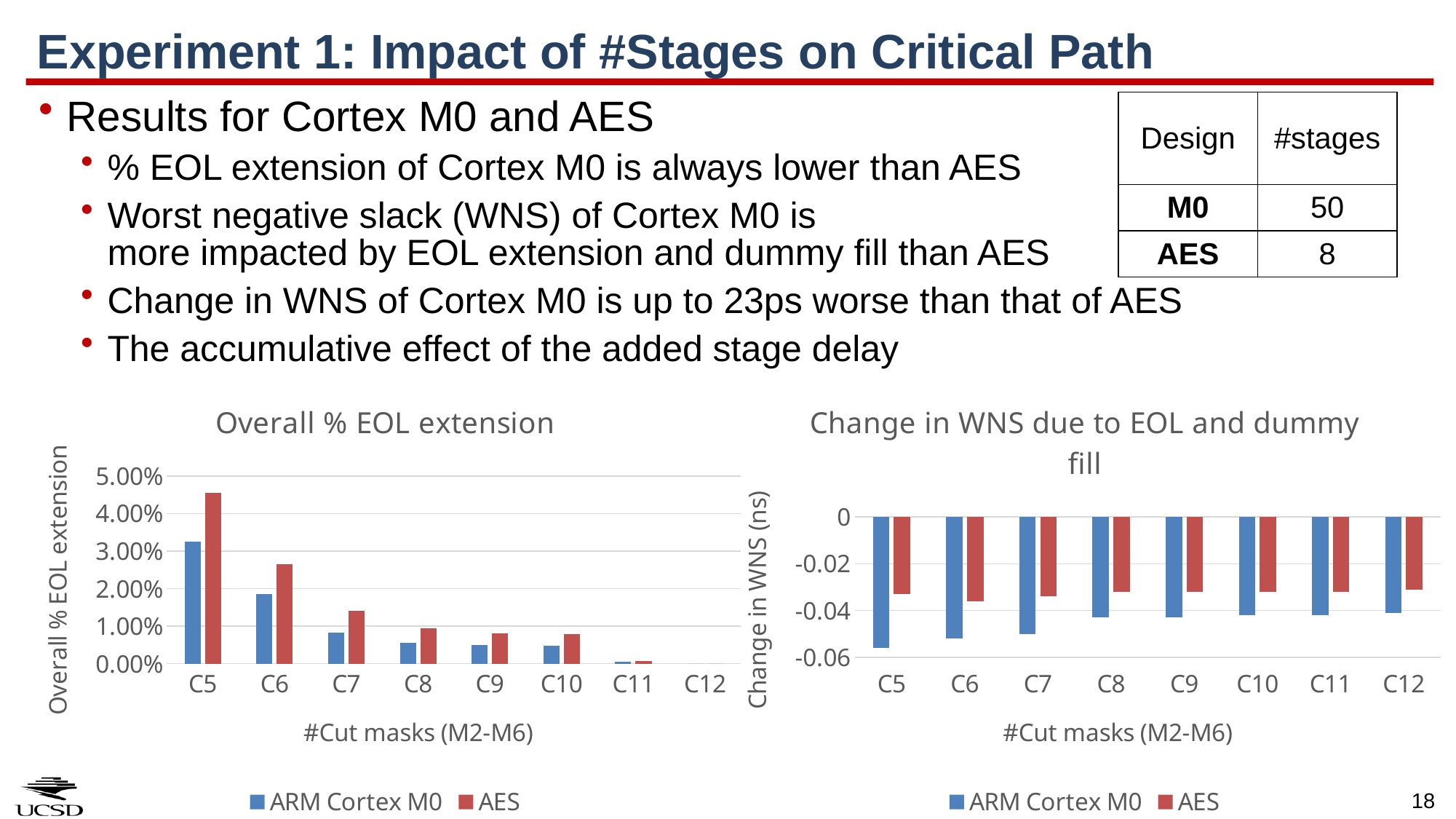
In the 'Overall % EOL extension' chart, is the ARM Cortex M0 value at C6 greater or less than 2.00%? less In the 'Overall % EOL extension' chart, which category has the highest AES value? C5 What is the x-axis label of the 'Change in WNS due to EOL and dummy fill' chart? #Cut masks (M2-M6) In the 'Overall % EOL extension' chart, do the values generally rise or fall from C5 to C12? fall What kind of chart is the 'Overall % EOL extension' chart? bar chart In the 'Overall % EOL extension' chart, is the AES value at C5 greater or less than 4.00%? greater In the 'Change in WNS due to EOL and dummy fill' chart, at C7, which series has the lower (more negative) value, ARM Cortex M0 or AES? ARM Cortex M0 In the 'Change in WNS due to EOL and dummy fill' chart, is the ARM Cortex M0 value at C5 greater or less than -0.04? less How many series does the legend of the 'Change in WNS due to EOL and dummy fill' chart list? 2 In the 'Overall % EOL extension' chart, at C5, which series has the larger value, ARM Cortex M0 or AES? AES How many cut-mask categories are shown on the x axis of the 'Overall % EOL extension' chart? 8